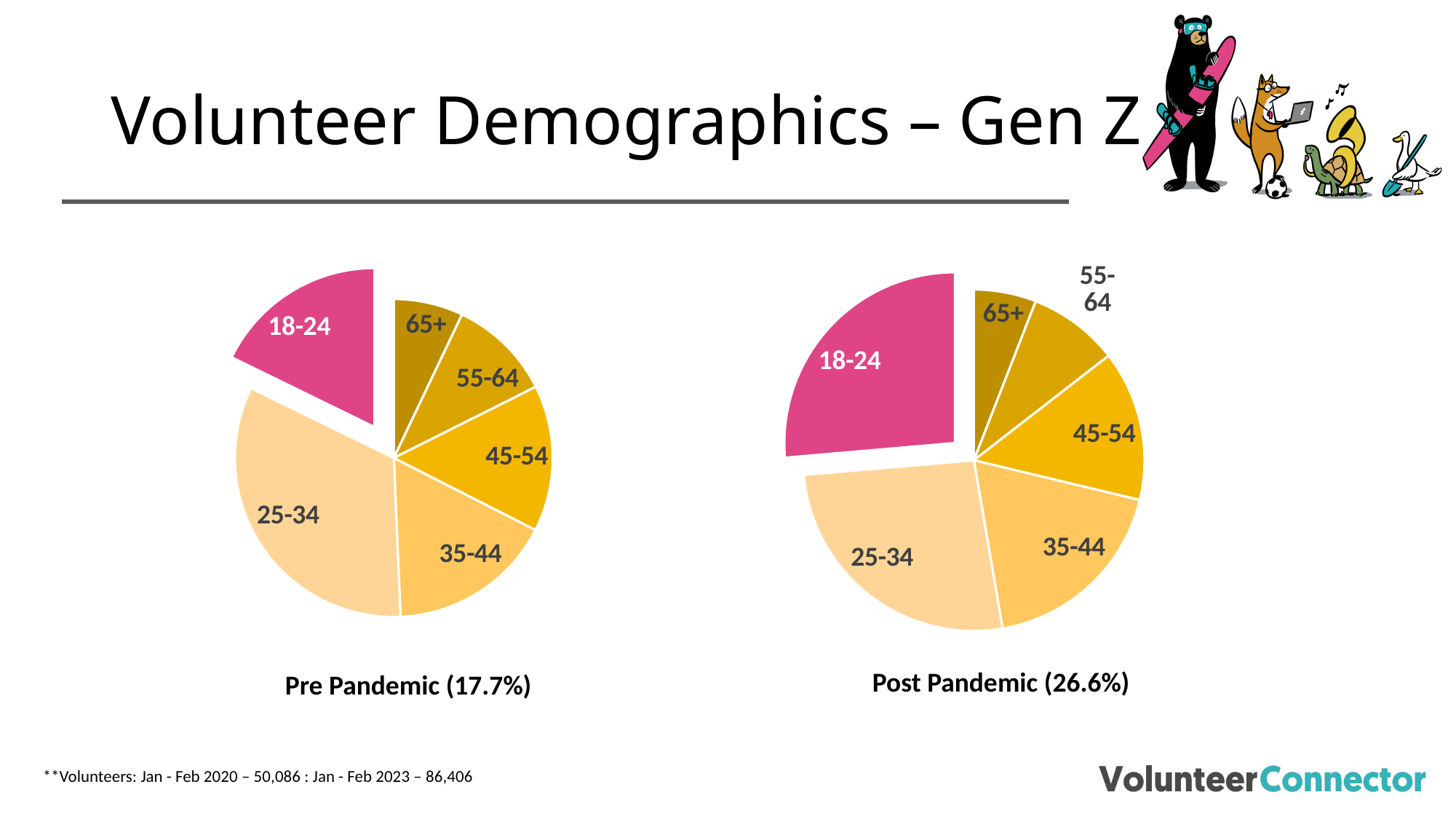
In the Pre Pandemic chart, which age group has the smallest slice? 65+ Is the 18-24 share larger in the Pre Pandemic chart or the Post Pandemic chart? Post Pandemic In the Pre Pandemic chart, what share of volunteers were aged 18-24? 17.7% By how many percentage points did the 18-24 share change from the Pre Pandemic chart (17.7%) to the Post Pandemic chart (26.6%)? 8.9 percentage points In both pie charts, which age group's slice is coloured pink and pulled out from the pie? 18-24 In the Post Pandemic chart, which age group has the smallest slice? 65+ What kind of chart is the Pre Pandemic chart? Pie chart In the Post Pandemic chart, what share of volunteers were aged 18-24? 26.6% In the Pre Pandemic chart, which age group has the largest slice? 25-34 In the Pre Pandemic chart, which slice is larger: 25-34 or 35-44? 25-34 How many age-group slices does the Post Pandemic pie chart have? 6